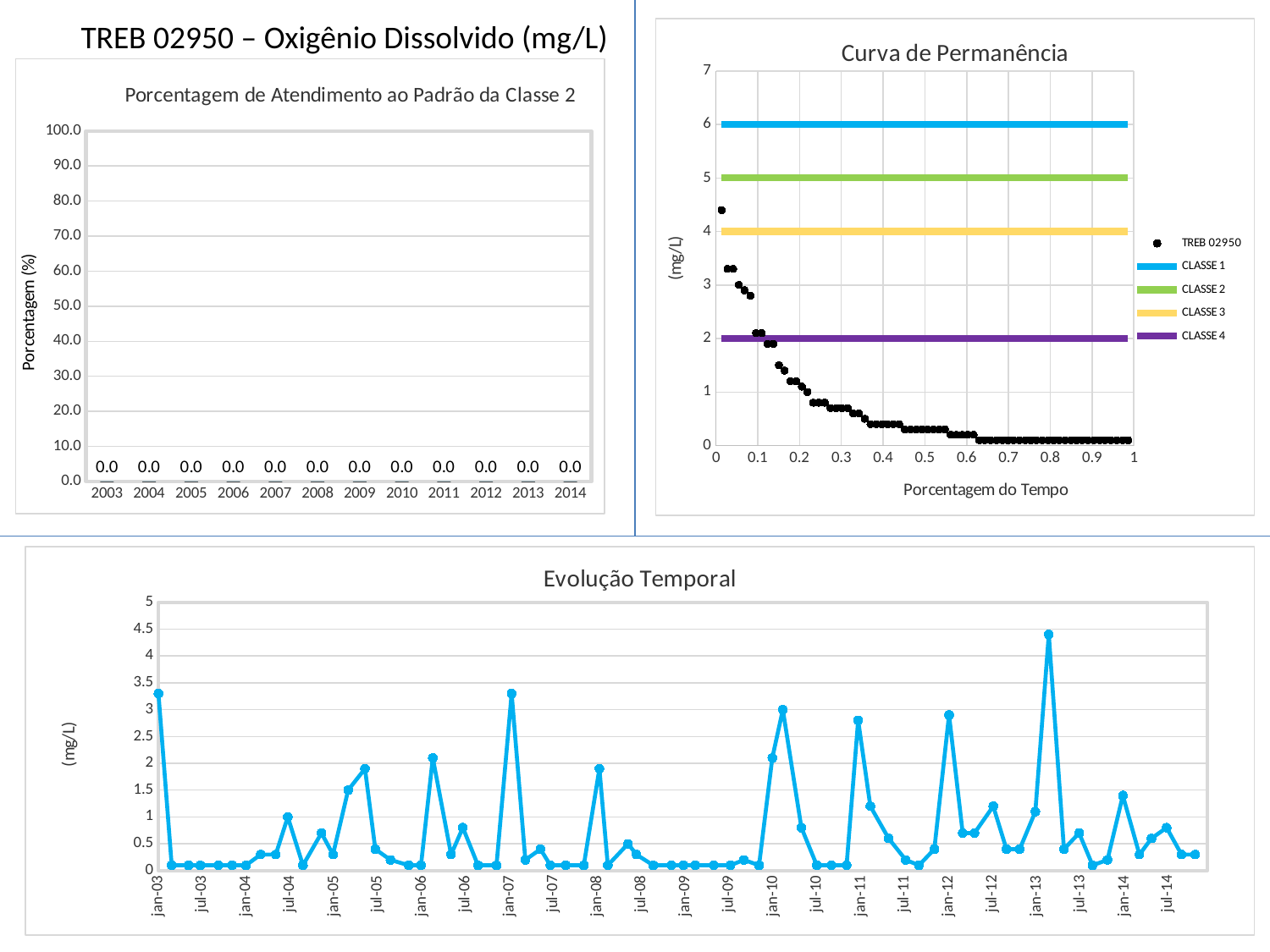
In the chart titled 'Curva de Permanência', at what mg/L level is the CLASSE 1 line drawn? 6 In the chart titled 'Curva de Permanência', which is higher, the CLASSE 2 line or the CLASSE 3 line? CLASSE 2 In the chart titled 'Curva de Permanência', do the TREB 02950 values rise or fall as Porcentagem do Tempo increases? fall In the chart titled 'Porcentagem de Atendimento ao Padrão da Classe 2', what is the difference between the values for 2003 and 2014? 0.0 What kind of chart is 'Porcentagem de Atendimento ao Padrão da Classe 2'? bar chart In the chart titled 'Curva de Permanência', at what mg/L level is the CLASSE 4 line drawn? 2 In the chart titled 'Curva de Permanência', what colour is the CLASSE 4 line? purple In the chart titled 'Evolução Temporal', is the value at jan-07 greater or less than 3? greater In the chart titled 'Porcentagem de Atendimento ao Padrão da Classe 2', how many years are shown on the x axis? 12 In the chart titled 'Curva de Permanência', how many series does the legend list? 5 In the chart titled 'Porcentagem de Atendimento ao Padrão da Classe 2', what is the value for 2008? 0.0